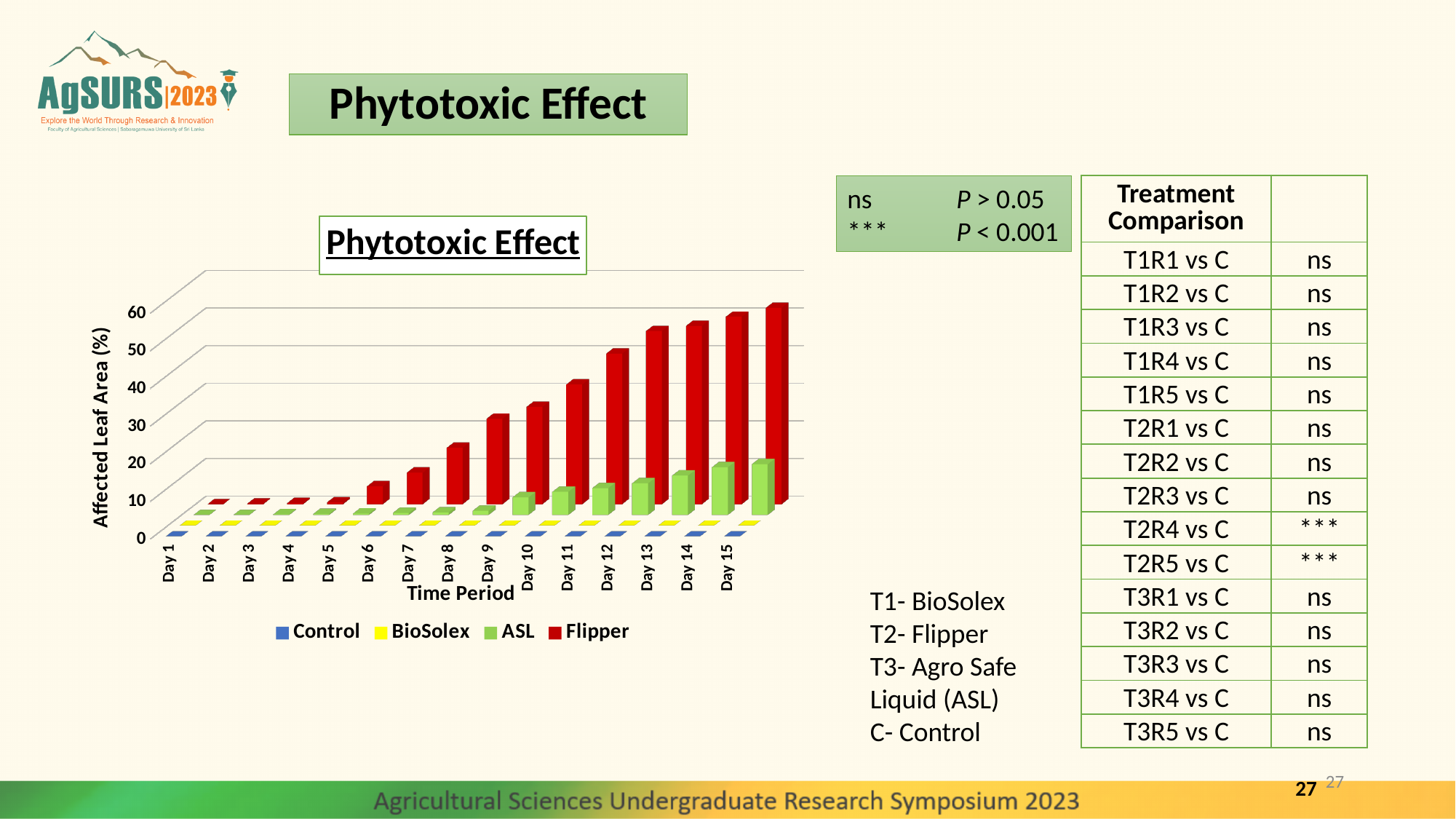
On which day does the Flipper series reach its highest value? Day 15 Which series has the highest value on Day 15? Flipper What is the label of the vertical axis of the chart? Affected Leaf Area (%) Does the Flipper series rise or fall from Day 1 to Day 15? rise Is the Flipper value on Day 15 greater or less than 40? greater Is the ASL value on Day 15 greater or less than 40? less How many days (categories) are shown on the x axis of the chart? 15 How many series does the chart legend list? 4 What kind of chart is shown on the slide? bar chart On Day 15, which is larger: the Flipper value or the ASL value? Flipper Is the Flipper value on Day 2 greater or less than 10? less Which colour represents the Flipper series in the chart legend? red